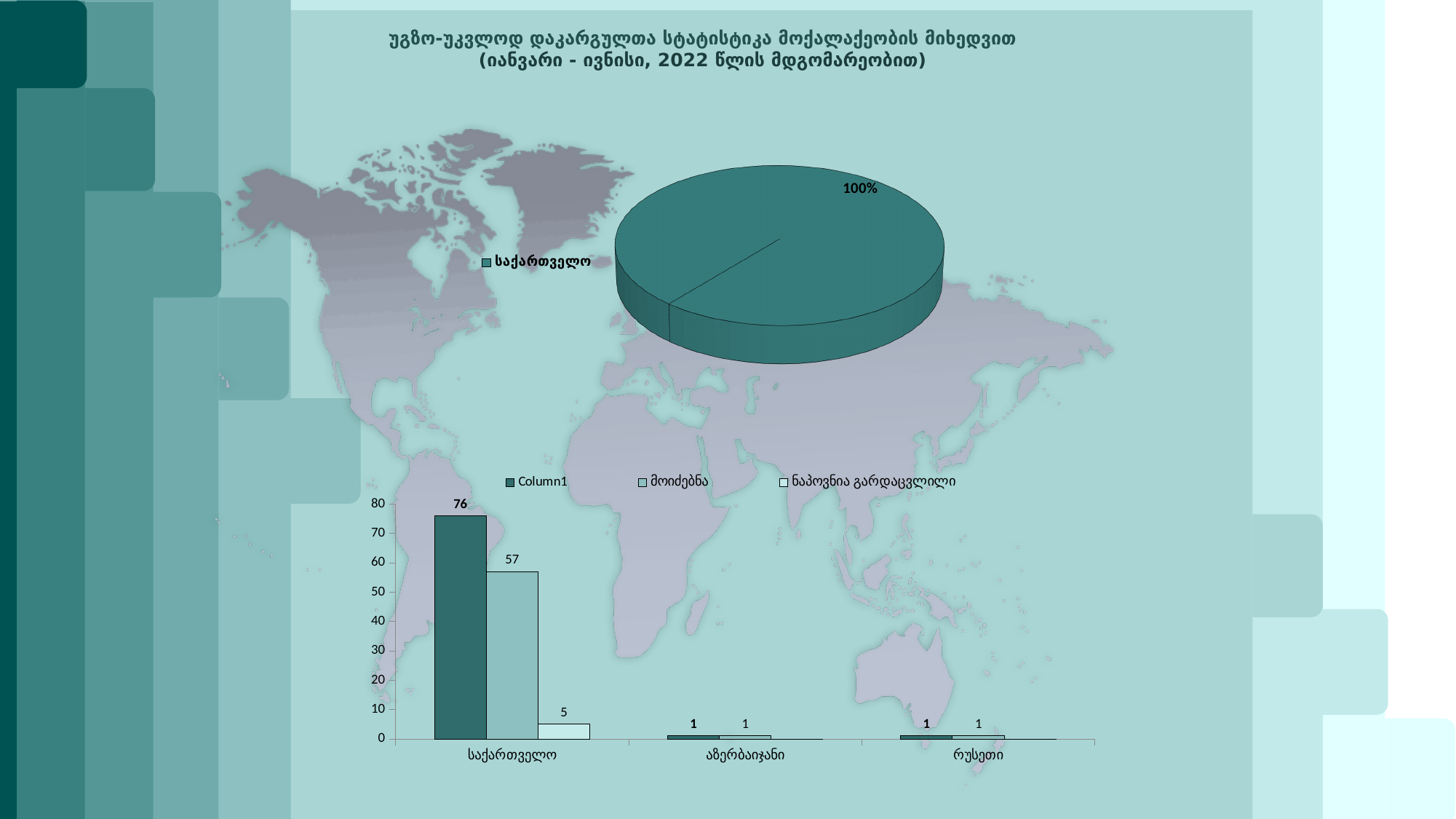
In the bar chart at the bottom of the slide, which is larger for საქართველო: მოიძებნა or ნაპოვნია გარდაცვლილი? მოიძებნა How many categories are shown on the x axis of the bar chart at the bottom of the slide? 3 In the bar chart at the bottom of the slide, what is the value of Column1 for აზერბაიჯანი? 1 In the bar chart at the bottom of the slide, what is the difference between the Column1 value and the მოიძებნა value for საქართველო? 19 What kind of chart is the chart at the top of the slide? Pie chart In the bar chart at the bottom of the slide, what is the value of Column1 for საქართველო? 76 In the bar chart at the bottom of the slide, what is the value of მოიძებნა for საქართველო? 57 In the bar chart at the bottom of the slide, what is the value of მოიძებნა for რუსეთი? 1 In the bar chart at the bottom of the slide, what is the value of ნაპოვნია გარდაცვლილი for საქართველო? 5 In the bar chart at the bottom of the slide, which category has the highest Column1 value? საქართველო In the pie chart at the top of the slide, what share is shown for საქართველო? 100% How many series does the legend of the bar chart at the bottom of the slide list? 3